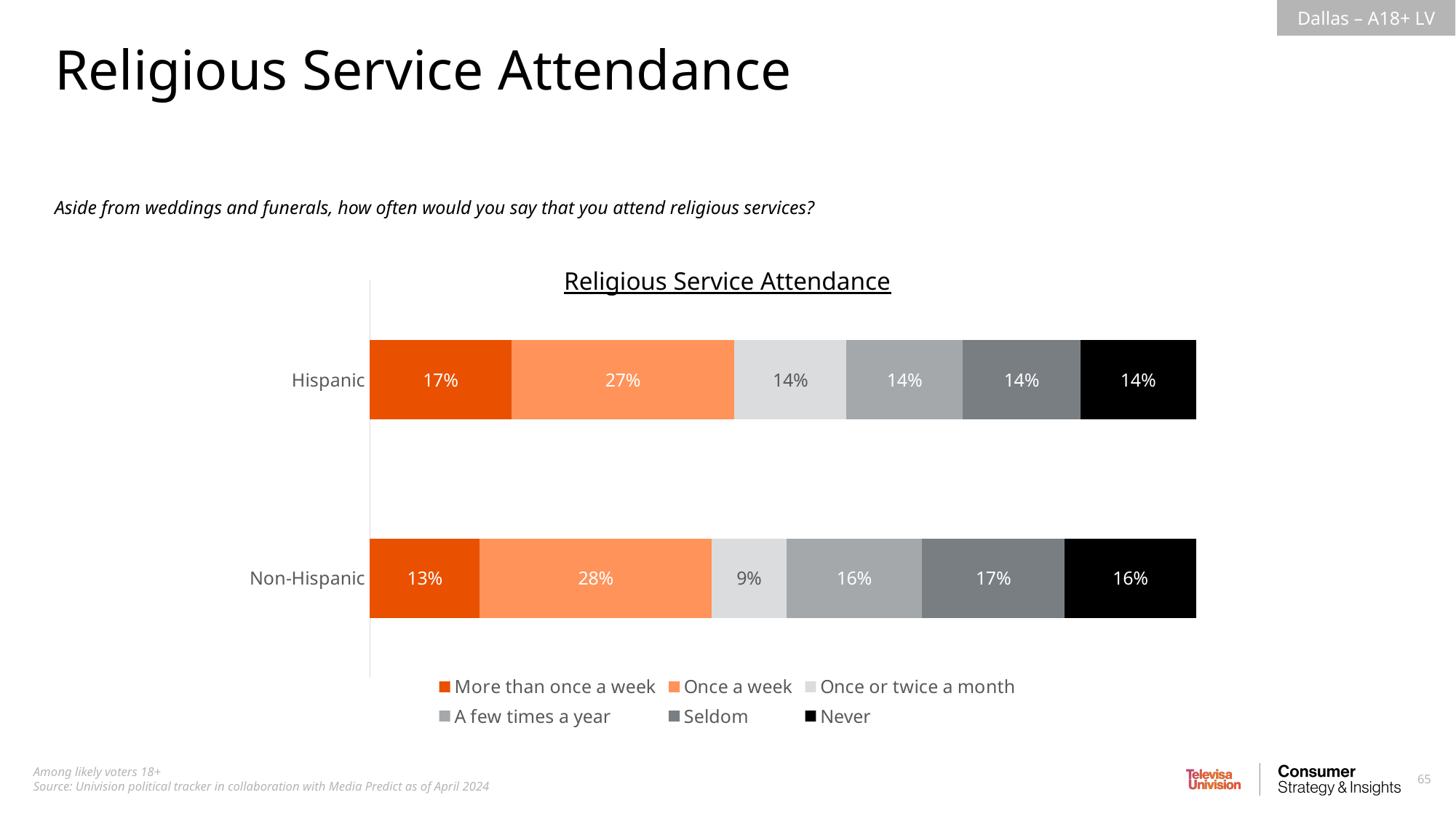
How many series does the legend list? 6 What percentage of Hispanic respondents attend religious services once a week? 27% Which group has a higher share attending more than once a week, Hispanic or Non-Hispanic? Hispanic What percentage of Hispanic respondents attend religious services more than once a week? 17% What colour represents the 'Never' category in the chart? Black Which attendance category has the smallest share among Non-Hispanic respondents? Once or twice a month How many groups (bars) are shown in the chart? 2 What percentage of Non-Hispanic respondents say they never attend religious services? 16% What kind of chart is shown on the slide? Stacked bar chart Which attendance category has the largest share among Non-Hispanic respondents? Once a week What is the difference between the Hispanic and Non-Hispanic shares for 'Once or twice a month'? 5 percentage points What percentage of Non-Hispanic respondents attend religious services once or twice a month? 9%